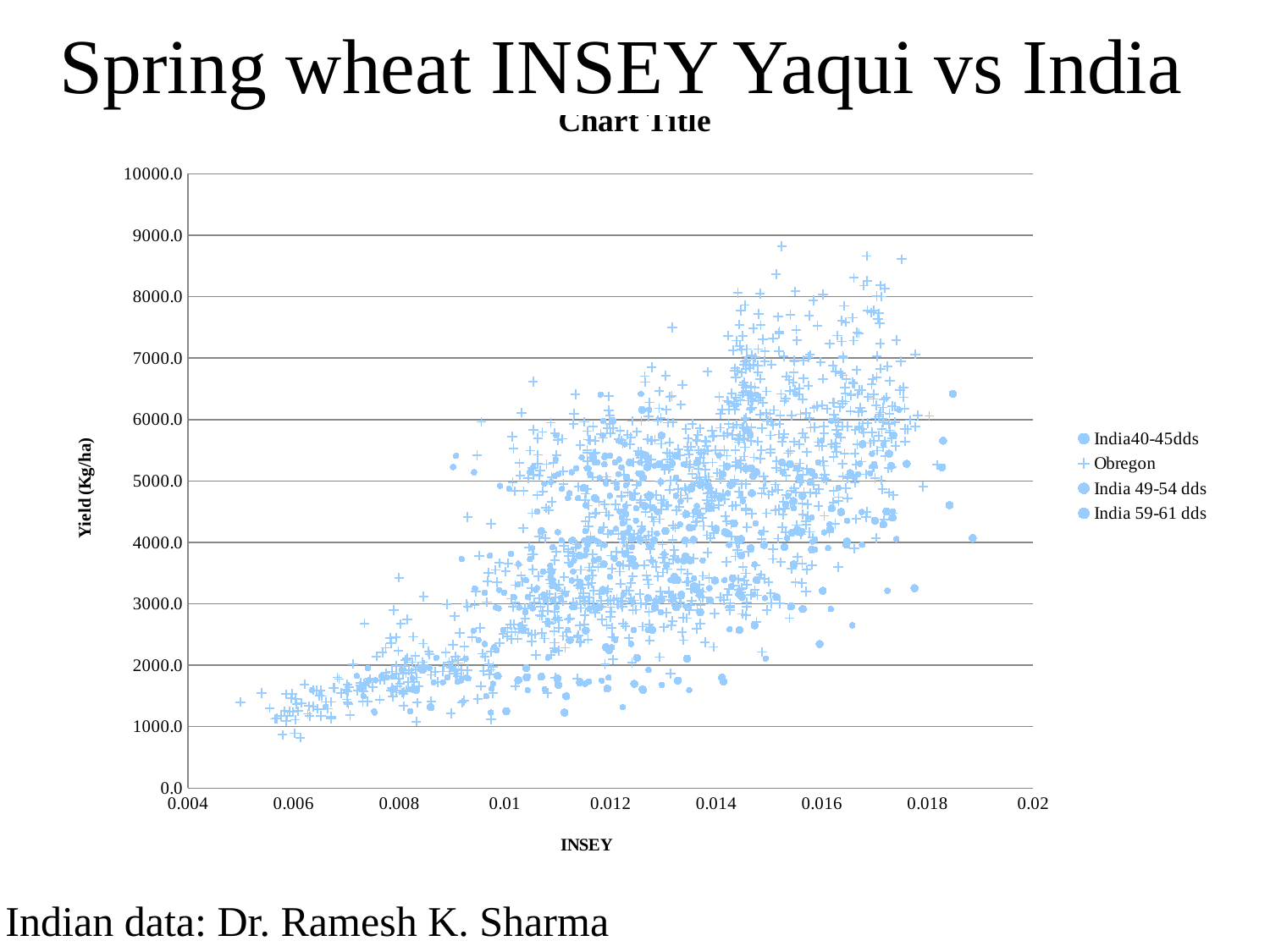
What is the minimum value shown on the x axis? 0.004 How many series does the legend list? 4 What kind of chart is shown on the slide? Scatter chart Which series is plotted with plus-sign markers rather than dots? Obregon What is the title of the y axis? Yield (Kg/ha) What is the maximum value shown on the y axis? 10000.0 Overall, does yield rise or fall as INSEY increases along the x axis? Rise Are the highest-yield points in the chart found at INSEY values greater or less than 0.012? greater What is the title of the x axis? INSEY Do any points in the chart exceed a yield of 9000.0? No What is the maximum value shown on the x axis? 0.02